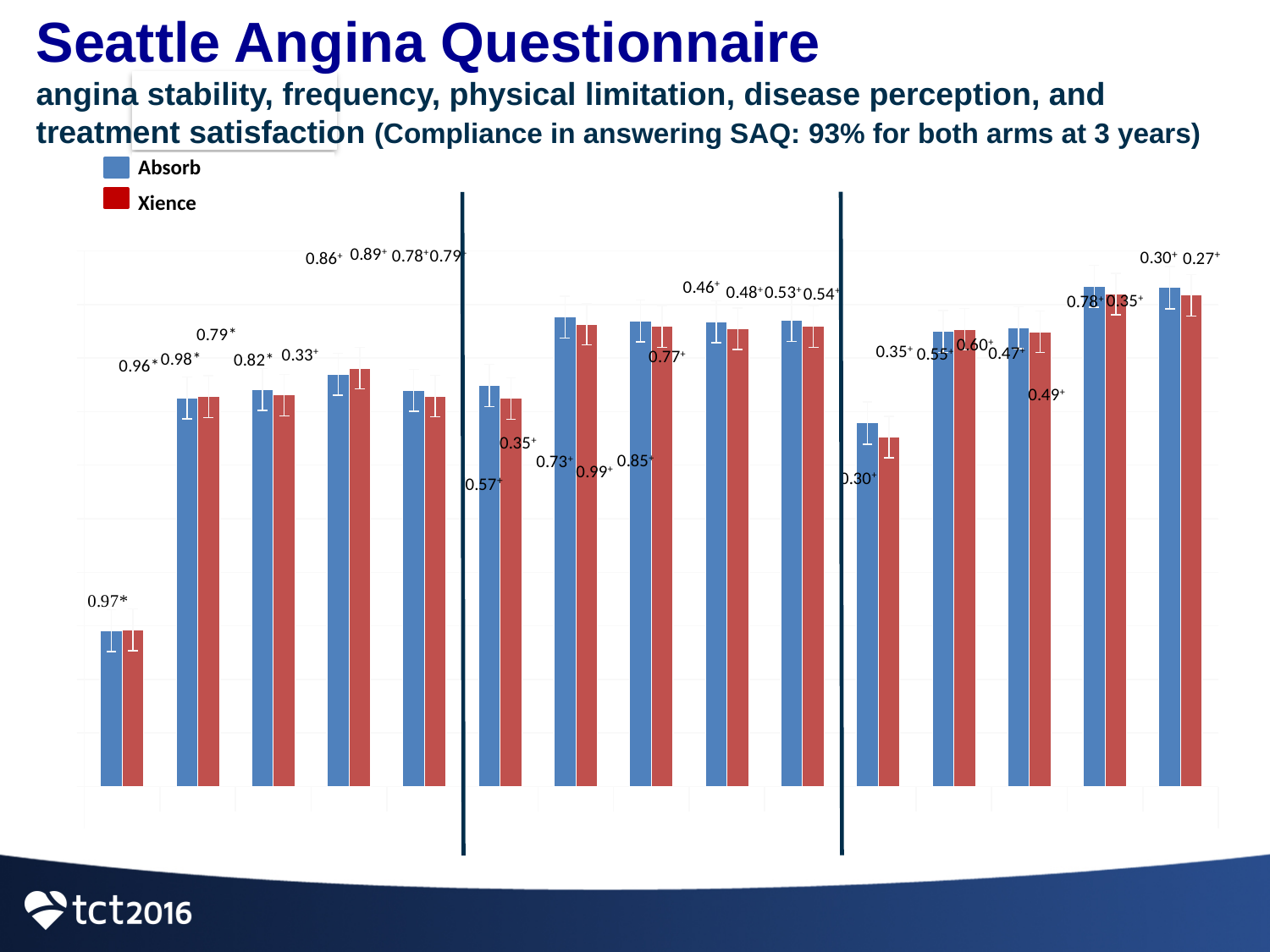
How many groups of paired bars are plotted in the chart? 15 How many series does the legend list? 2 Which is taller: the rightmost Absorb bar or the leftmost Absorb bar? the rightmost Absorb bar Which series is shown in blue in the legend? Absorb Which series is shown in red in the legend? Xience What kind of chart is shown on the slide? bar chart Which is taller: the first Absorb bar to the right of the second vertical divider line or the Absorb bar immediately to its right? the Absorb bar immediately to its right Which is taller: the leftmost Absorb bar or the second Absorb bar from the left? the second Absorb bar from the left